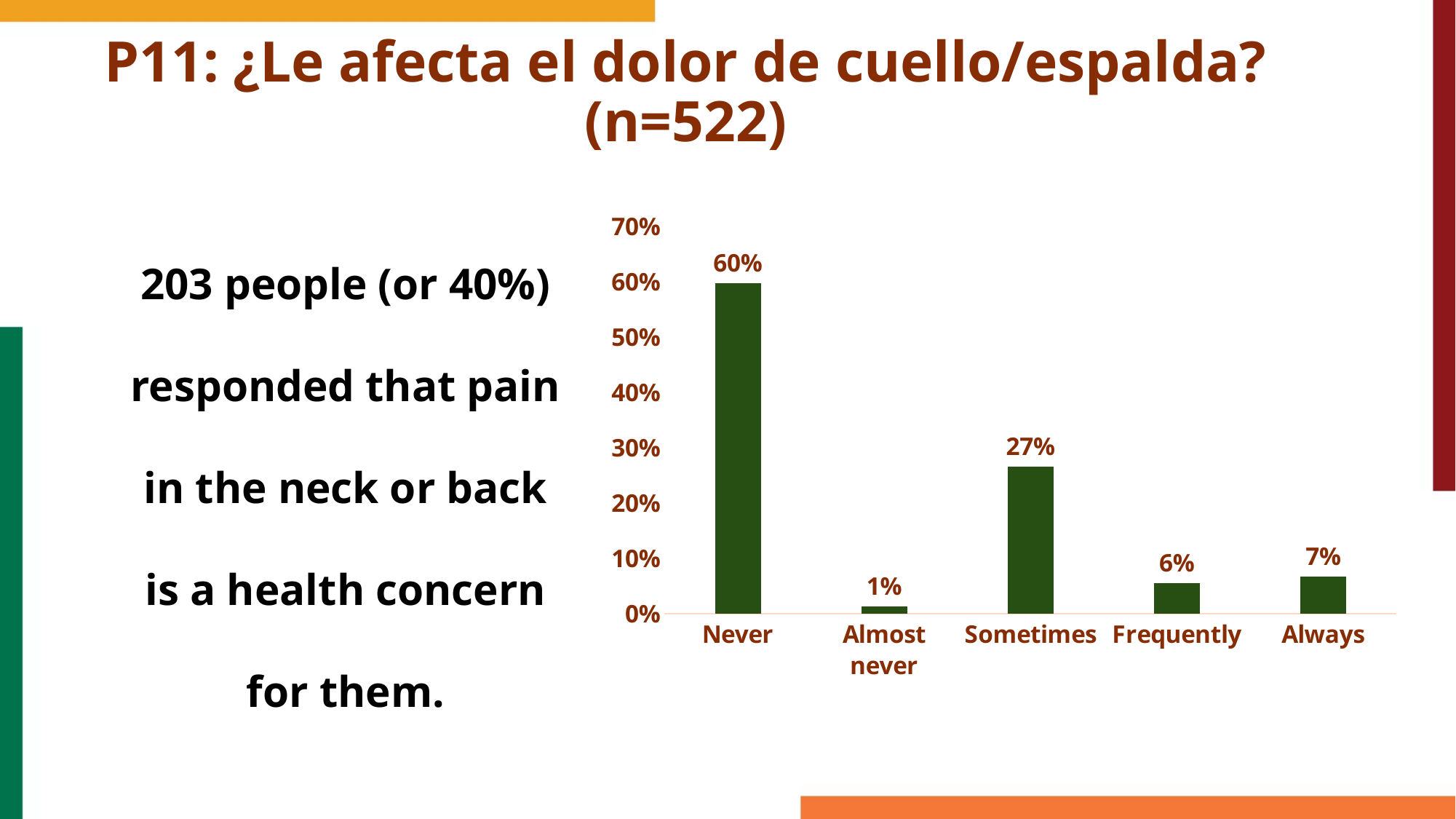
What is the value for Almost never? 1% What is the value for Frequently? 6% Which category has the highest value? Never Which is larger, the value for Frequently or the value for Always? Always What is the difference between the values for Never and Sometimes? 33% Which category has the lowest value? Almost never What is the value for Never? 60% What is the value for Sometimes? 27% What is the value for Always? 7% How many categories are shown on the x axis? 5 What kind of chart is shown on the slide? Bar chart What is the highest value shown on the y axis? 70%